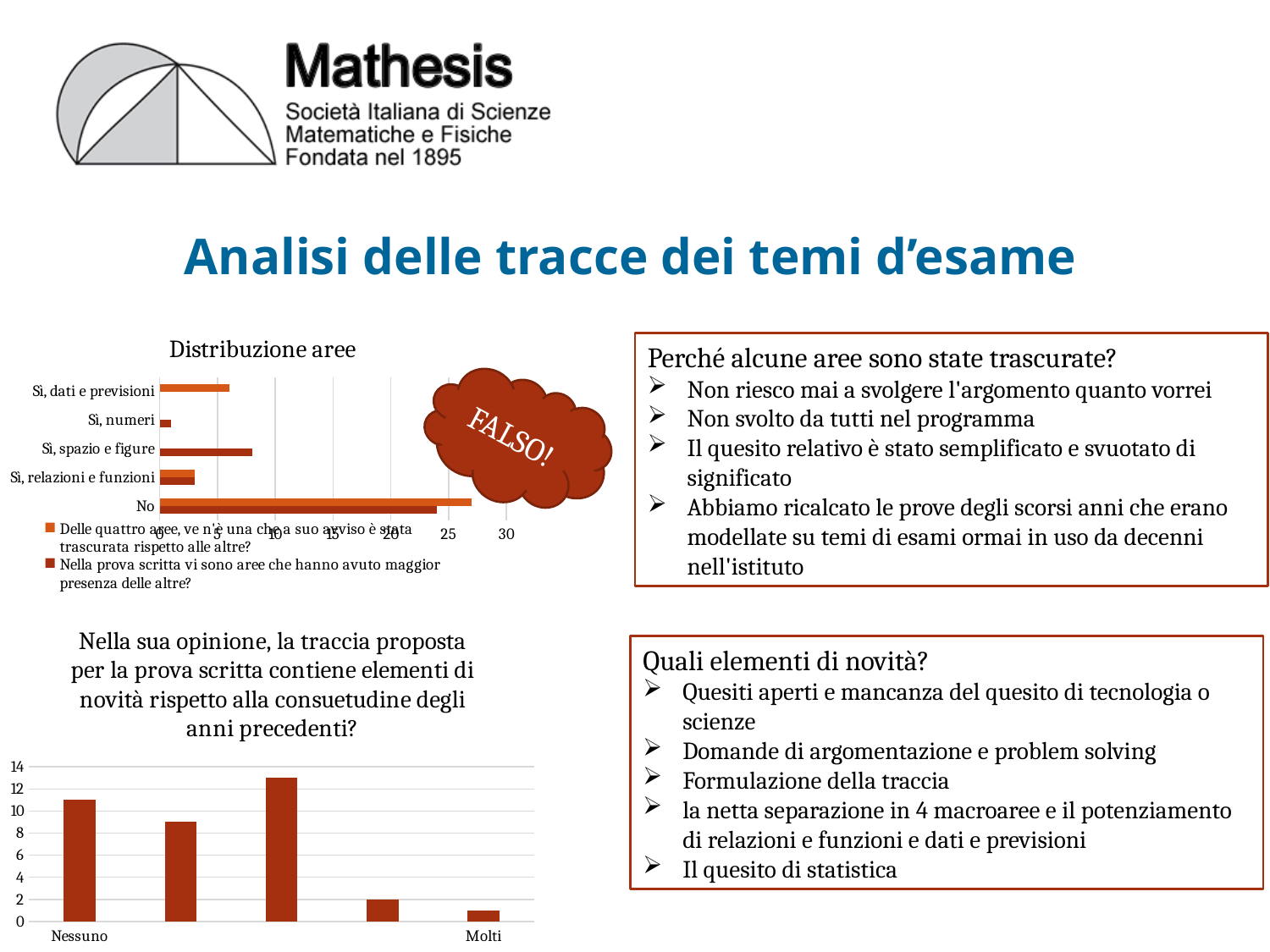
What is the title of the horizontal bar chart on the slide? Distribuzione aree How many bars are shown on the bottom-left chart about elementi di novità? 5 How many series does the legend of the "Distribuzione aree" chart list? 2 What kind of chart is the "Distribuzione aree" chart? bar chart In the "Distribuzione aree" chart, is the value for "No" in the "Delle quattro aree..." series greater or less than 20? greater What kind of chart is the bottom-left chart about elementi di novità? bar chart In the "Distribuzione aree" chart, which category has the highest value? No In the "Distribuzione aree" chart, which is larger: the value for "No" or the value for "Sì, spazio e figure"? No In the "Distribuzione aree" chart, is the value for "Sì, numeri" greater or less than 5? less On the bottom-left chart about elementi di novità, is the value for "Molti" greater or less than 2? less How many categories are shown on the "Distribuzione aree" chart? 5